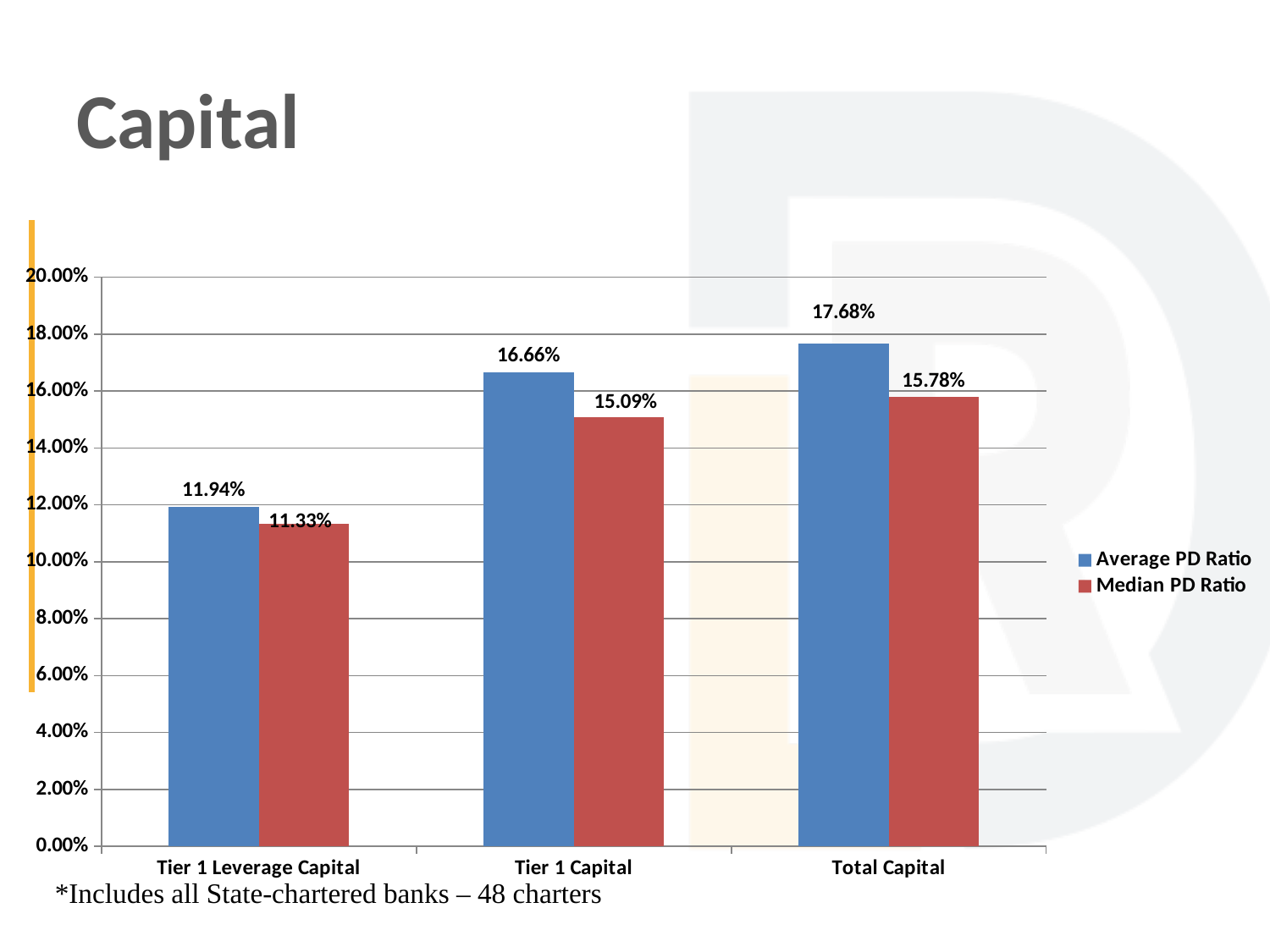
Which category has the lowest Median PD Ratio? Tier 1 Leverage Capital How many categories are shown on the x axis? 3 What kind of chart is shown on the slide? Bar chart Which category has the highest Average PD Ratio? Total Capital What is the difference between the Average PD Ratio and the Median PD Ratio for Tier 1 Capital? 1.57% What is the Median PD Ratio for Total Capital? 15.78% How many series does the legend list? 2 Which is larger for Total Capital, the Average PD Ratio or the Median PD Ratio? Average PD Ratio What is the Median PD Ratio for Tier 1 Leverage Capital? 11.33% What is the difference between the Average PD Ratio for Total Capital and the Average PD Ratio for Tier 1 Leverage Capital? 5.74% Is the Median PD Ratio for Tier 1 Capital greater or less than 14.00%? greater What is the Average PD Ratio for Tier 1 Capital? 16.66%